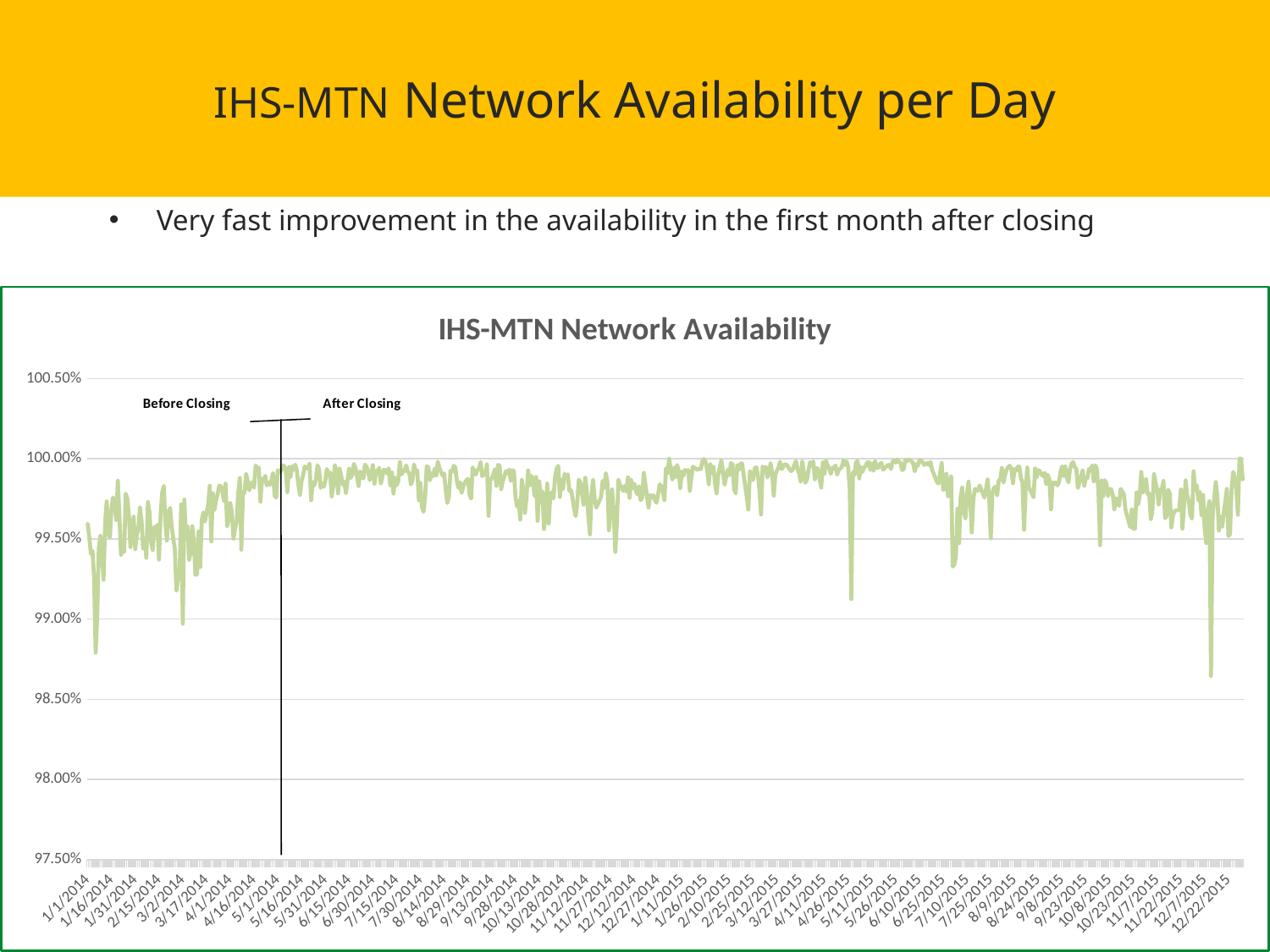
Does network availability generally rise or fall from the period before closing to the period after closing? Rise What is the title of the chart? IHS-MTN Network Availability Is the lowest dip in availability in January 2014 greater or less than 99.00%? less What is the first date label on the chart's x-axis? 1/1/2014 What is the last date label on the chart's x-axis? 12/22/2015 What kind of chart is shown on the slide? Line chart What are the two annotation labels shown above the vertical divider line in the chart? Before Closing and After Closing What is the highest value shown on the chart's y-axis? 100.50% What is the lowest value shown on the chart's y-axis? 97.50% Is the availability around 5/11/2015 greater or less than 99.50%? greater Is the availability around 6/15/2014 greater or less than 99.50%? greater